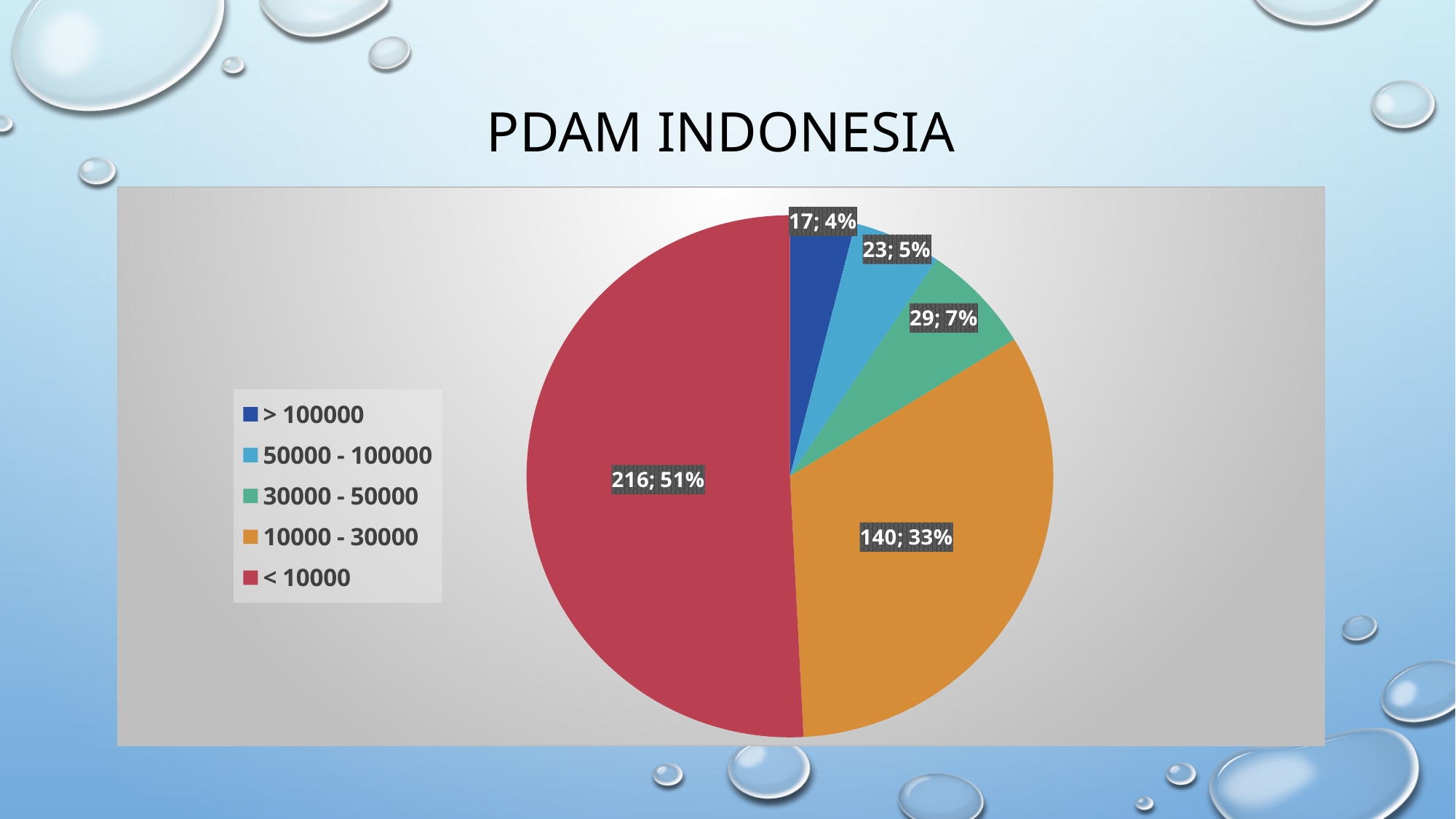
What share of the pie does the 50000 - 100000 slice represent? 5% What is the value for the 10000 - 30000 category? 140 What kind of chart is shown on the slide? pie chart Which category has the largest slice? < 10000 How many categories does the legend list? 5 What is the value for the > 100000 category? 17 What share of the pie does the < 10000 slice represent? 51% What is the difference between the values for < 10000 and 10000 - 30000? 76 Which is larger, the value for 30000 - 50000 or the value for 50000 - 100000? 30000 - 50000 What is the value for the 30000 - 50000 category? 29 Which category has the smallest slice? > 100000 What is the value for the < 10000 category? 216